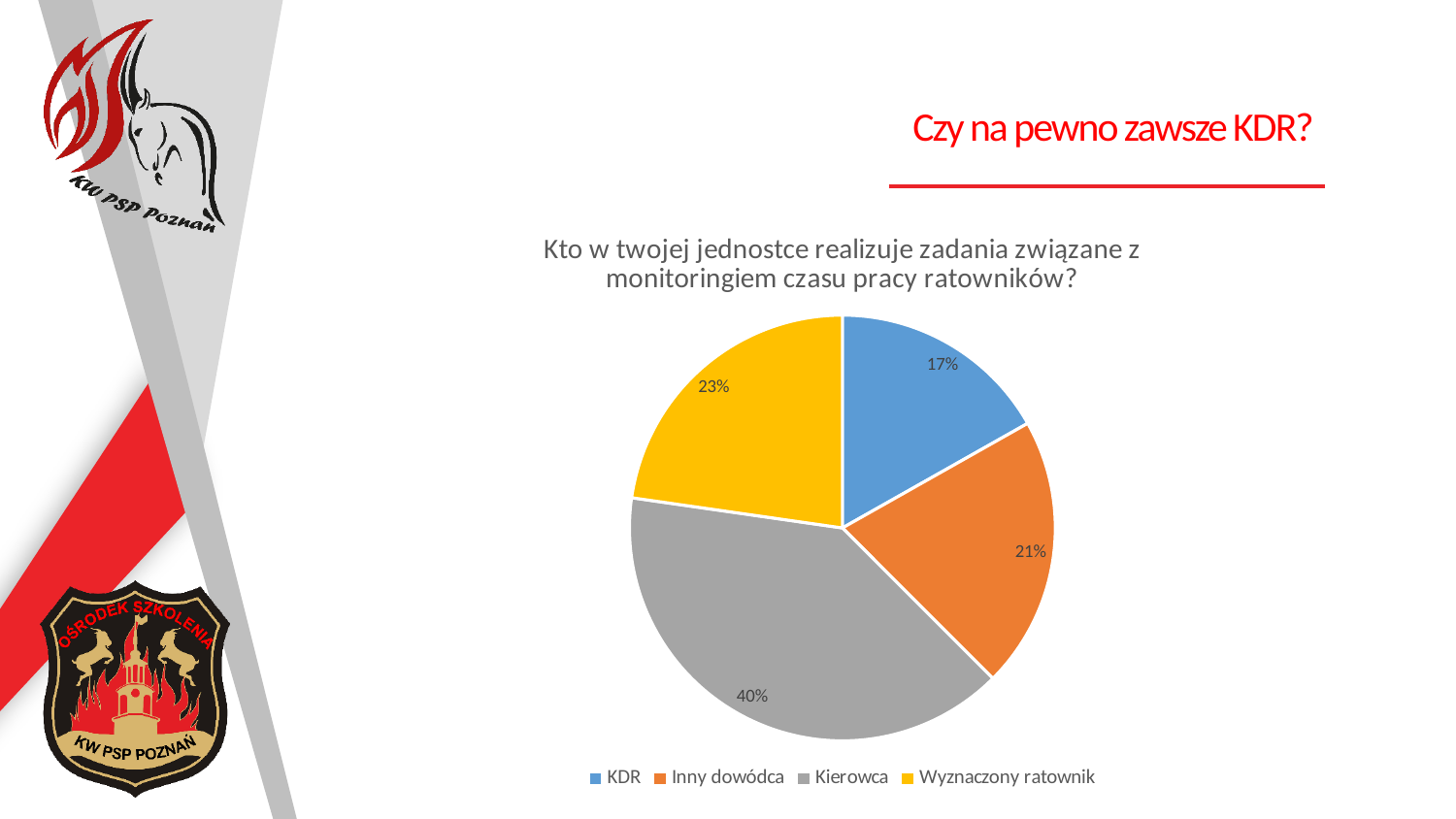
Which category has the smallest slice? KDR Which is larger, Wyznaczony ratownik or Inny dowódca? Wyznaczony ratownik What kind of chart is shown on the slide? pie chart What is the value for Wyznaczony ratownik? 23% What is the value for Inny dowódca? 21% What is the difference between the values for Kierowca and KDR? 23% What share of the pie does Kierowca have? 40% How many categories does the pie chart have? 4 What colour is the Kierowca slice? grey What is the value for KDR? 17% Which category has the largest slice? Kierowca What is the title of the chart? Kto w twojej jednostce realizuje zadania związane z monitoringiem czasu pracy ratowników?